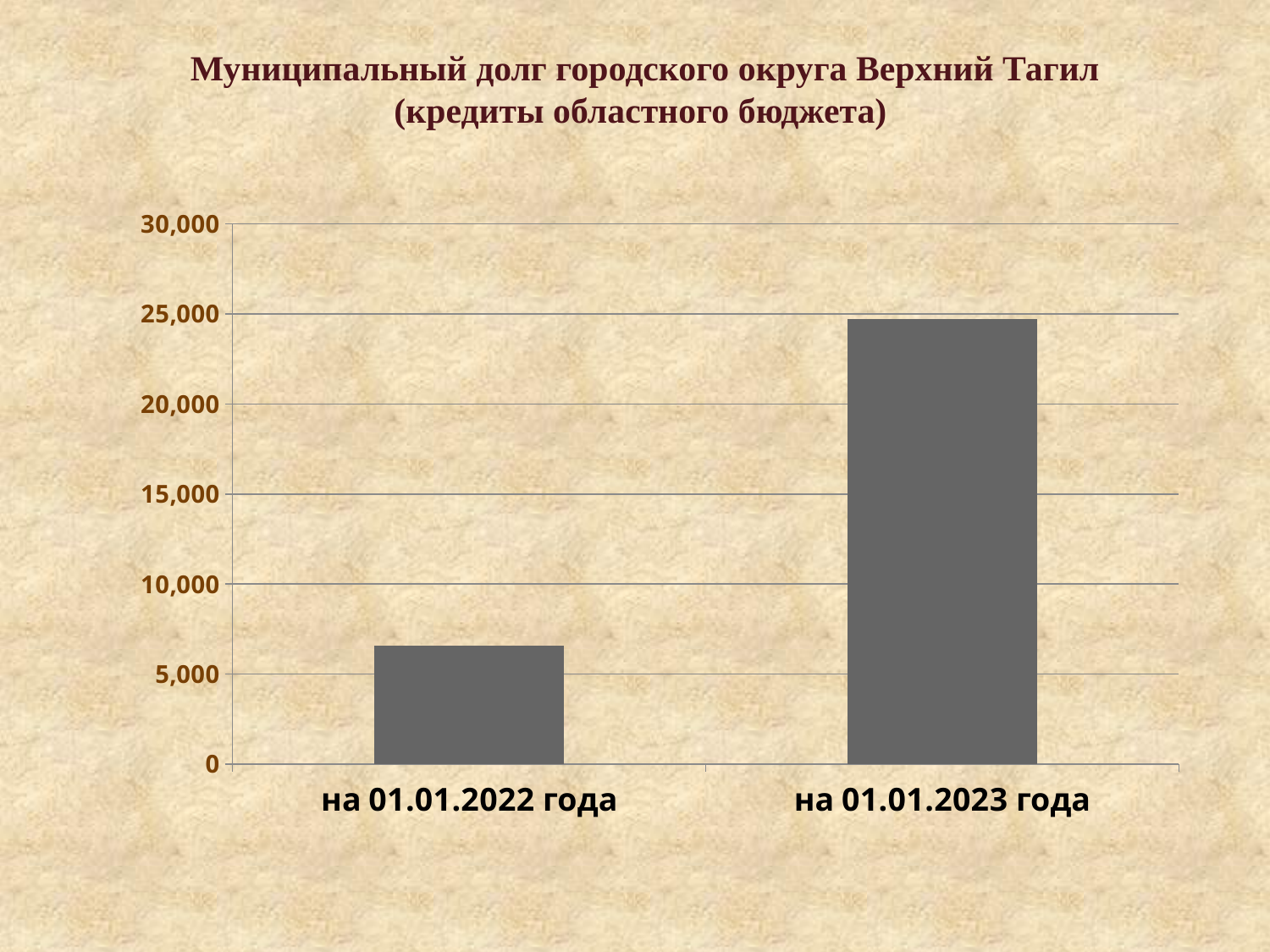
What kind of chart is shown on the slide? bar chart What is the highest value shown on the vertical axis? 30,000 Is the value for на 01.01.2022 года greater or less than 5,000? greater What is the title of the chart? Муниципальный долг городского округа Верхний Тагил (кредиты областного бюджета) Is the value for на 01.01.2023 года greater or less than 20,000? greater Do the values rise or fall from на 01.01.2022 года to на 01.01.2023 года? rise How many bars (categories) are plotted in the chart? 2 Is the value for на 01.01.2023 года greater or less than 30,000? less Which is larger: the value for на 01.01.2022 года or the value for на 01.01.2023 года? на 01.01.2023 года Which category has the lowest value? на 01.01.2022 года Which category has the highest value? на 01.01.2023 года